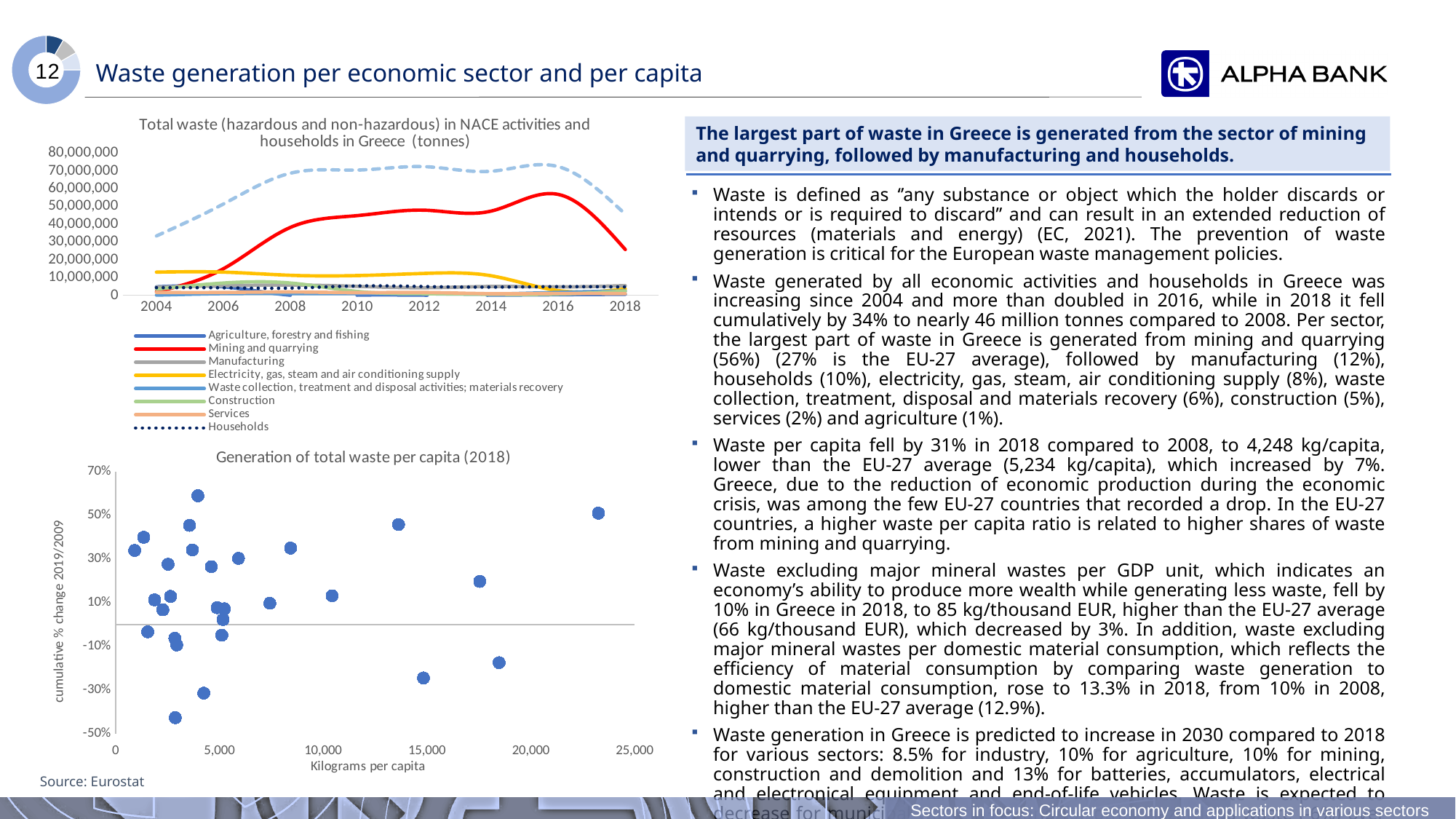
In the top chart, is the value for Mining and quarrying in 2016 greater or less than 50,000,000? greater In the bottom chart, what is the label of the x axis? Kilograms per capita What kind of chart is the bottom chart titled 'Generation of total waste per capita (2018)'? scatter chart In the top chart, how many series does the legend list? 8 In the top chart, is the value for Electricity, gas, steam and air conditioning supply in 2004 greater or less than 10,000,000? greater In the top chart, is the value for Mining and quarrying in 2004 greater or less than 10,000,000? less In the top chart, which is larger in 2010: Mining and quarrying or Electricity, gas, steam and air conditioning supply? Mining and quarrying What source is cited for the charts on the slide? Eurostat In the top chart, which legend series has the highest value in 2016? Mining and quarrying What kind of chart is the top chart titled 'Total waste (hazardous and non-hazardous) in NACE activities and households in Greece (tonnes)'? line chart In the top chart, does the Mining and quarrying line rise or fall between 2016 and 2018? fall